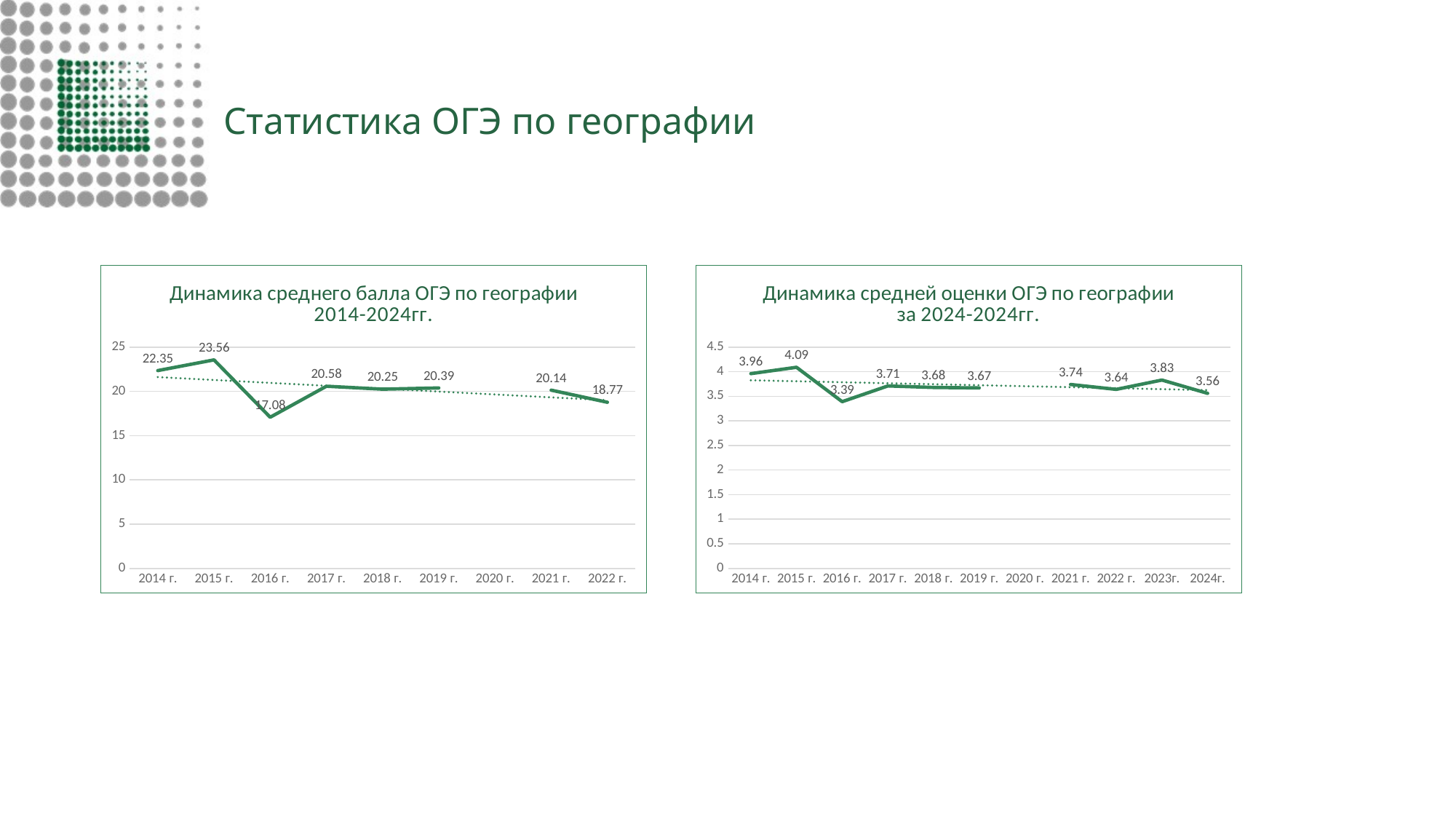
In the right chart (Динамика средней оценки ОГЭ по географии), which is larger: the value for 2021 г. or the value for 2022 г.? 2021 г. In the right chart (Динамика средней оценки ОГЭ по географии), which year has the highest value? 2015 г. In the right chart (Динамика средней оценки ОГЭ по географии), how many year categories are shown on the x axis? 11 In the right chart (Динамика средней оценки ОГЭ по географии), what is the value for 2023г.? 3.83 In the left chart (Динамика среднего балла ОГЭ по географии), what type of chart is shown? Line chart In the left chart (Динамика среднего балла ОГЭ по географии), what is the value for 2015 г.? 23.56 In the left chart (Динамика среднего балла ОГЭ по географии), what is the value for 2022 г.? 18.77 In the right chart (Динамика средней оценки ОГЭ по географии), what is the difference between the values for 2014 г. and 2024г.? 0.4 In the left chart (Динамика среднего балла ОГЭ по географии), what is the difference between the values for 2015 г. and 2016 г.? 6.48 In the left chart (Динамика среднего балла ОГЭ по географии), which year has the lowest value? 2016 г. In the right chart (Динамика средней оценки ОГЭ по географии), what is the value for 2016 г.? 3.39 In the left chart (Динамика среднего балла ОГЭ по географии), which year has the highest value? 2015 г.